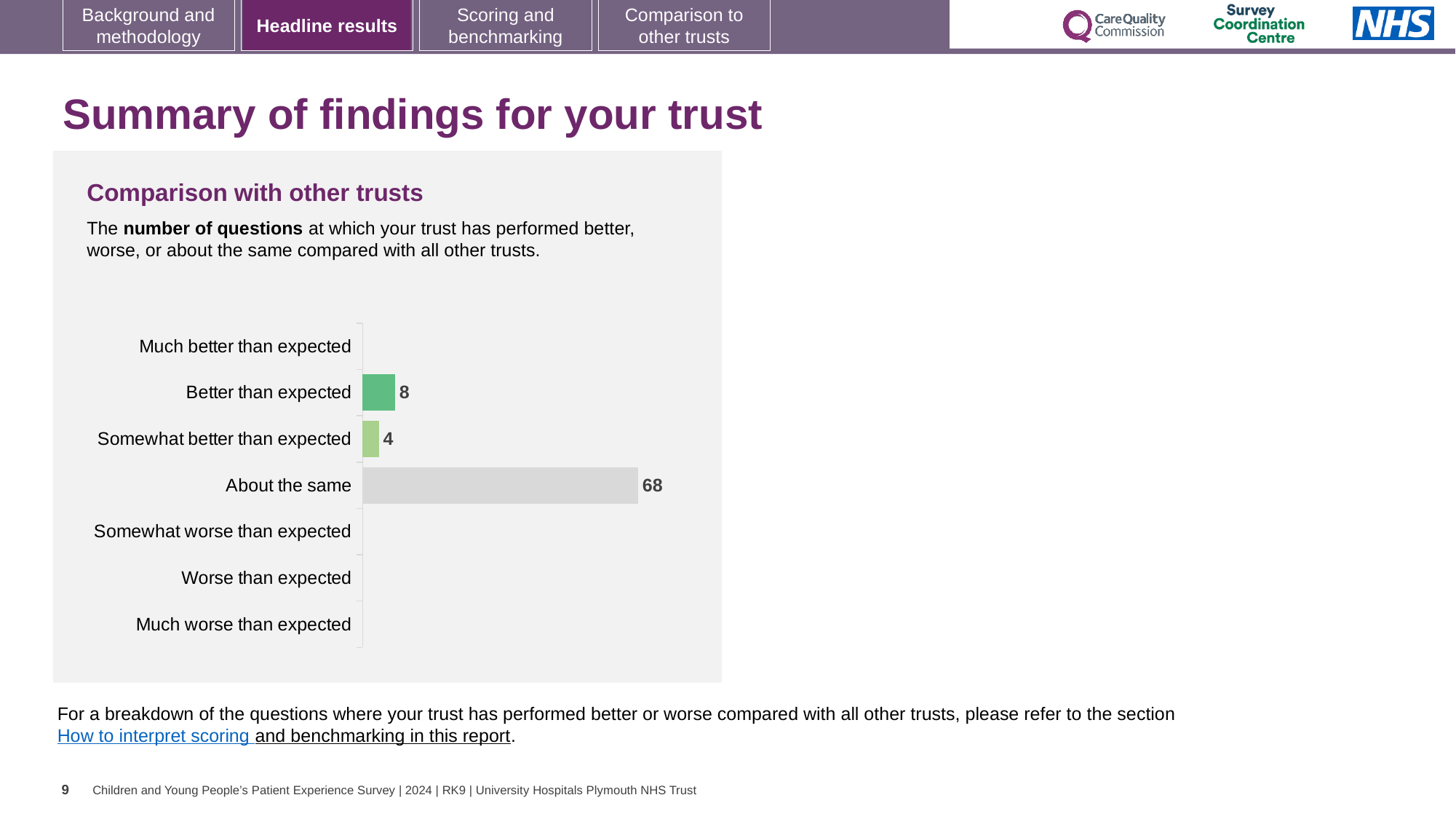
What is the difference between the number of questions rated 'Better than expected' and 'Somewhat better than expected'? 4 How many questions were rated 'Somewhat better than expected'? 4 How many questions were rated 'Better than expected'? 8 What is the total number of questions across the three categories with bars shown? 80 What is the title of the chart section on the slide? Comparison with other trusts What kind of chart is shown on the slide? Bar chart How many categories are listed on the chart's axis? 7 What colour is the bar for 'About the same'? Grey How many questions were rated 'About the same'? 68 Which has more questions: 'Better than expected' or 'Somewhat better than expected'? Better than expected Which category has the highest number of questions? About the same What is the difference between the number of questions rated 'About the same' and 'Better than expected'? 60